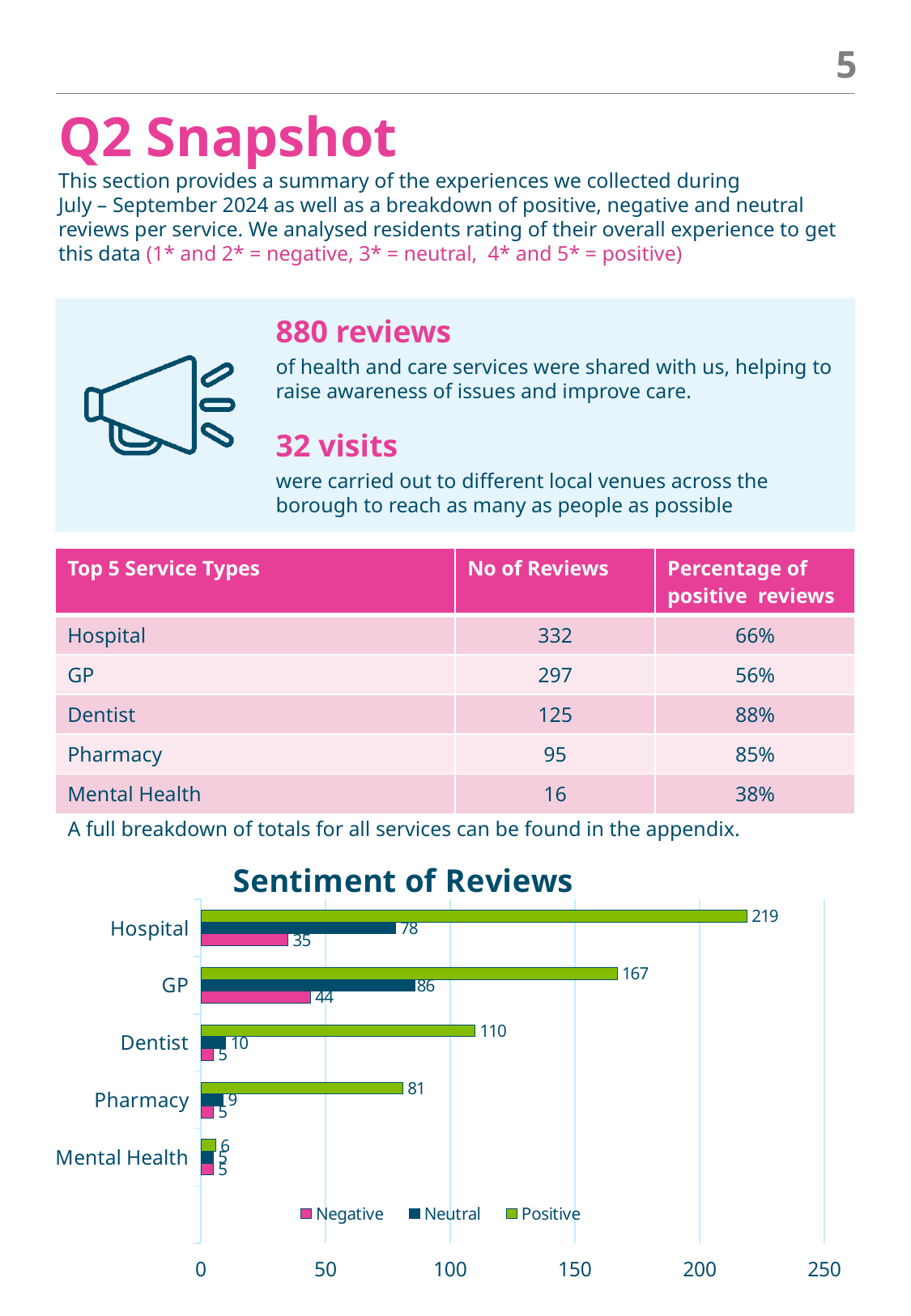
What type of chart is the "Sentiment of Reviews" chart? Bar chart In the "Sentiment of Reviews" chart, what is the difference between the Positive values for Hospital and GP? 52 In the "Sentiment of Reviews" chart, what is the Neutral value for GP? 86 How many service categories are shown in the "Sentiment of Reviews" chart? 5 In the "Sentiment of Reviews" chart, what is the Positive value for Pharmacy? 81 In the "Sentiment of Reviews" chart, which is larger: the Negative value for GP or the Negative value for Hospital? GP In the "Sentiment of Reviews" chart, which service has the lowest Positive value? Mental Health In the "Sentiment of Reviews" chart, which service has the highest Positive value? Hospital In the "Sentiment of Reviews" chart, what is the Negative value for Dentist? 5 In the "Sentiment of Reviews" chart, what is the Positive value for Hospital? 219 In the "Sentiment of Reviews" chart, is the Positive value for GP greater or less than 150? greater How many series does the legend of the "Sentiment of Reviews" chart list? 3